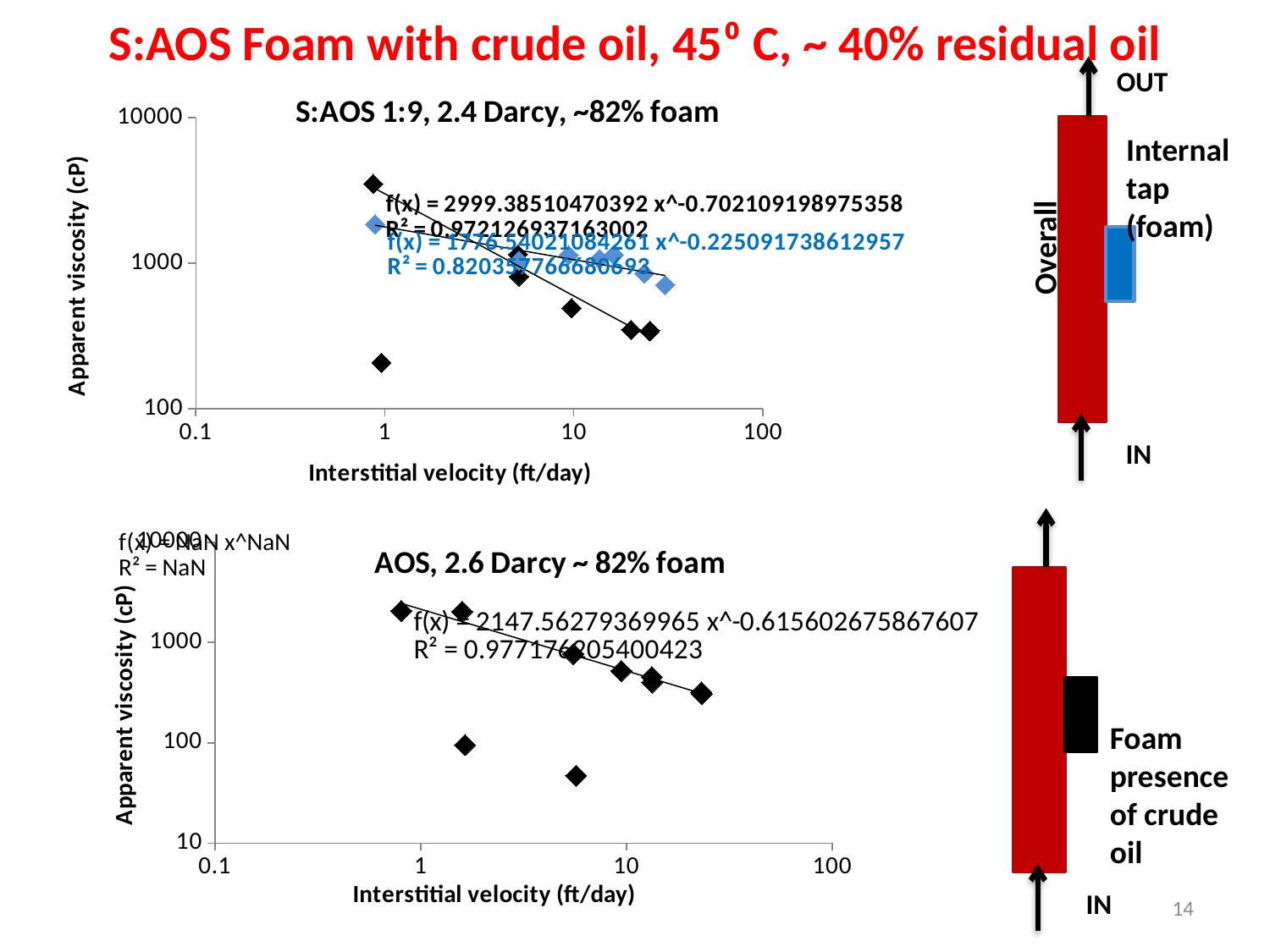
What kind of chart is the top chart titled 'S:AOS 1:9, 2.4 Darcy, ~82% foam'? Scatter chart In the bottom chart 'AOS, 2.6 Darcy ~ 82% foam', is the data point at the highest velocity (around 25 ft/day) greater or less than 1000 cP? less In the top chart 'S:AOS 1:9, 2.4 Darcy, ~82% foam', is the lowest black data point near 1 ft/day greater or less than 1000 cP? less In the top chart 'S:AOS 1:9, 2.4 Darcy, ~82% foam', is the highest black data point near 1 ft/day greater or less than 1000 cP? greater What is the exponent of x in the blue fitted equation shown on the top chart 'S:AOS 1:9, 2.4 Darcy, ~82% foam'? -0.225091738612957 What is the label of the y axis on the top chart 'S:AOS 1:9, 2.4 Darcy, ~82% foam'? Apparent viscosity (cP) What is the exponent of x in the fitted equation shown on the bottom chart 'AOS, 2.6 Darcy ~ 82% foam'? -0.615602675867607 In the top chart 'S:AOS 1:9, 2.4 Darcy, ~82% foam', does apparent viscosity rise or fall as interstitial velocity increases? Fall What is the exponent of x in the black fitted equation shown on the top chart 'S:AOS 1:9, 2.4 Darcy, ~82% foam'? -0.702109198975358 In the bottom chart 'AOS, 2.6 Darcy ~ 82% foam', does the fitted trend line rise or fall as interstitial velocity increases? Fall What is the label of the x axis on the bottom chart 'AOS, 2.6 Darcy ~ 82% foam'? Interstitial velocity (ft/day)